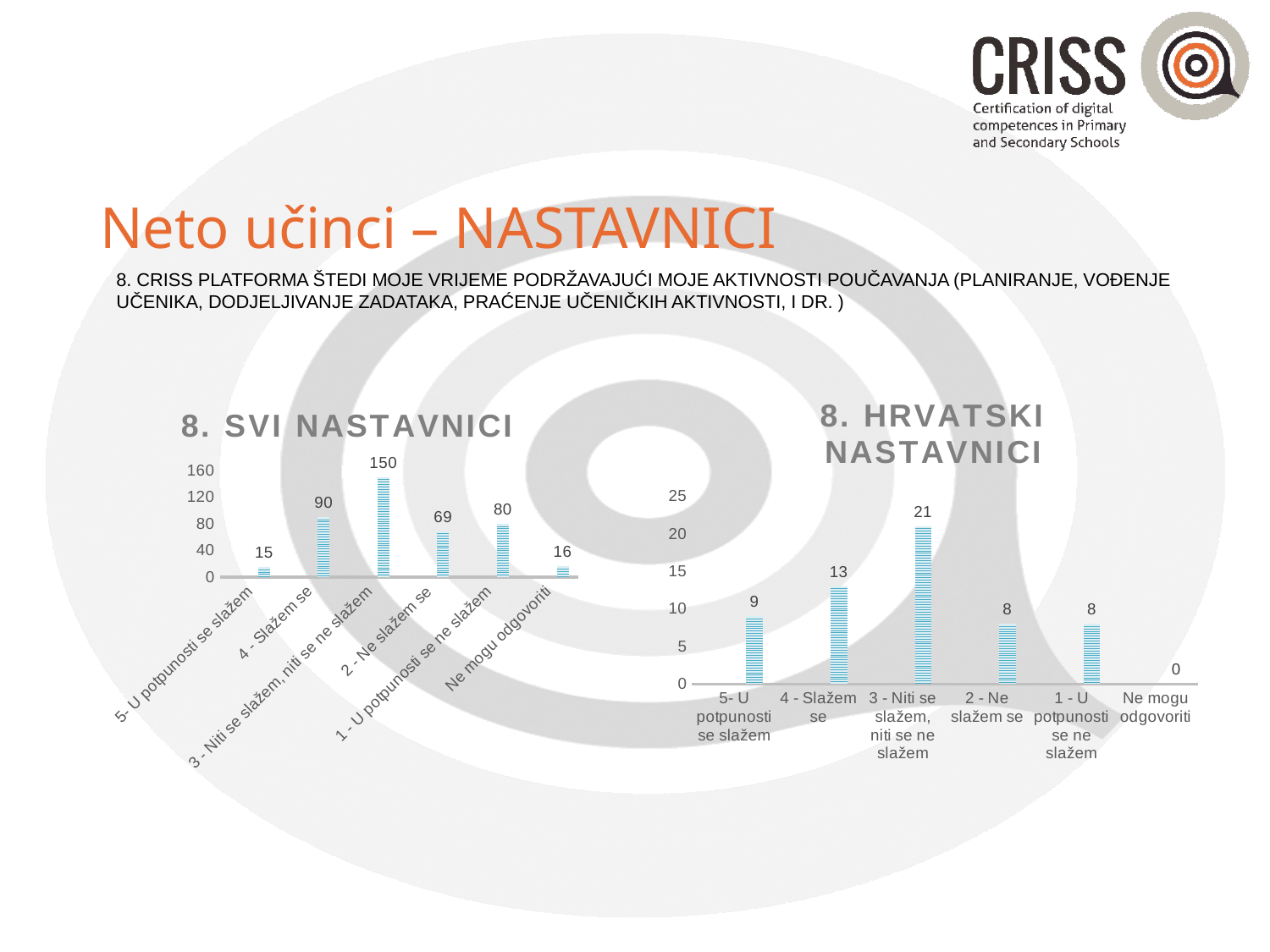
In the chart titled "8. SVI NASTAVNICI", what is the value for "3 - Niti se slažem, niti se ne slažem"? 150 What kind of chart is the chart titled "8. HRVATSKI NASTAVNICI"? Bar chart In the chart titled "8. SVI NASTAVNICI", which category has the lowest value? 5- U potpunosti se slažem In the chart titled "8. HRVATSKI NASTAVNICI", which category has the highest value? 3 - Niti se slažem, niti se ne slažem In the chart titled "8. HRVATSKI NASTAVNICI", what is the difference between the values for "4 - Slažem se" and "5- U potpunosti se slažem"? 4 In the chart titled "8. SVI NASTAVNICI", which is larger: the value for "1 - U potpunosti se ne slažem" or the value for "2 - Ne slažem se"? 1 - U potpunosti se ne slažem In the chart titled "8. SVI NASTAVNICI", what is the value for "5- U potpunosti se slažem"? 15 In the chart titled "8. SVI NASTAVNICI", what is the difference between the values for "4 - Slažem se" and "2 - Ne slažem se"? 21 What is the title of the chart on the left side of the slide? 8. SVI NASTAVNICI In the chart titled "8. HRVATSKI NASTAVNICI", what is the value for "Ne mogu odgovoriti"? 0 In the chart titled "8. HRVATSKI NASTAVNICI", what is the value for "3 - Niti se slažem, niti se ne slažem"? 21 In the chart titled "8. SVI NASTAVNICI", how many categories are shown on the x axis? 6